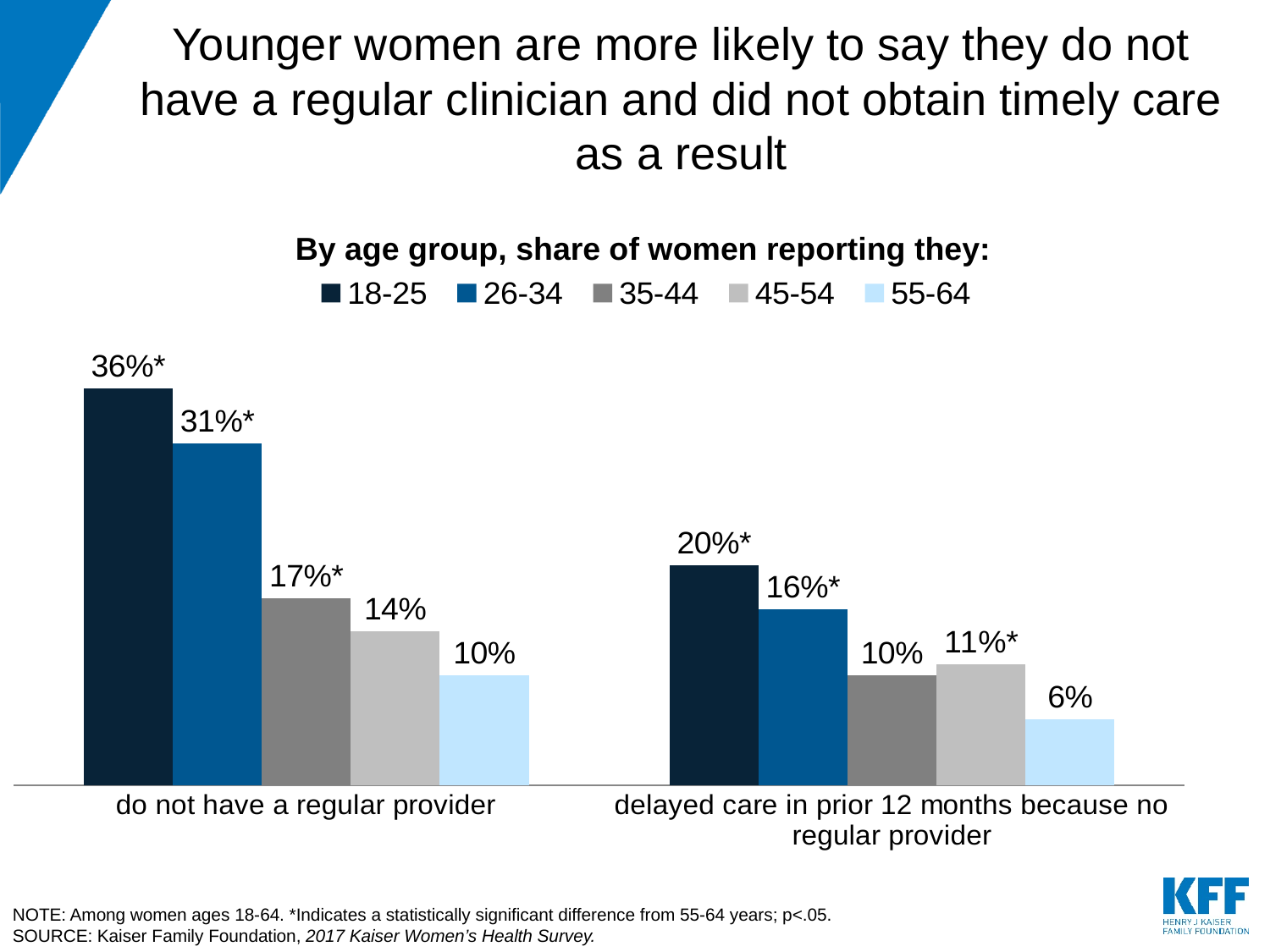
How many categories are shown on the x axis? 2 How many age groups does the legend list? 5 For delayed care in the prior 12 months because no regular provider, which is larger: the share for 35-44 or for 45-54? 45-54 What share of women aged 55-64 report they delayed care in the prior 12 months because they had no regular provider? 6% What is the difference in percentage points between the 18-25 and 26-34 groups for delaying care because no regular provider? 4 What is the difference in percentage points between the 18-25 and 55-64 groups for not having a regular provider? 26 Which age group has the highest share reporting they do not have a regular provider? 18-25 What share of women aged 18-25 report they do not have a regular provider? 36% What share of women aged 45-54 report they do not have a regular provider? 14% Which age group has the lowest share reporting they delayed care in the prior 12 months because no regular provider? 55-64 What is the subtitle printed above the legend of the chart? By age group, share of women reporting they: What kind of chart is shown on the slide? Bar chart